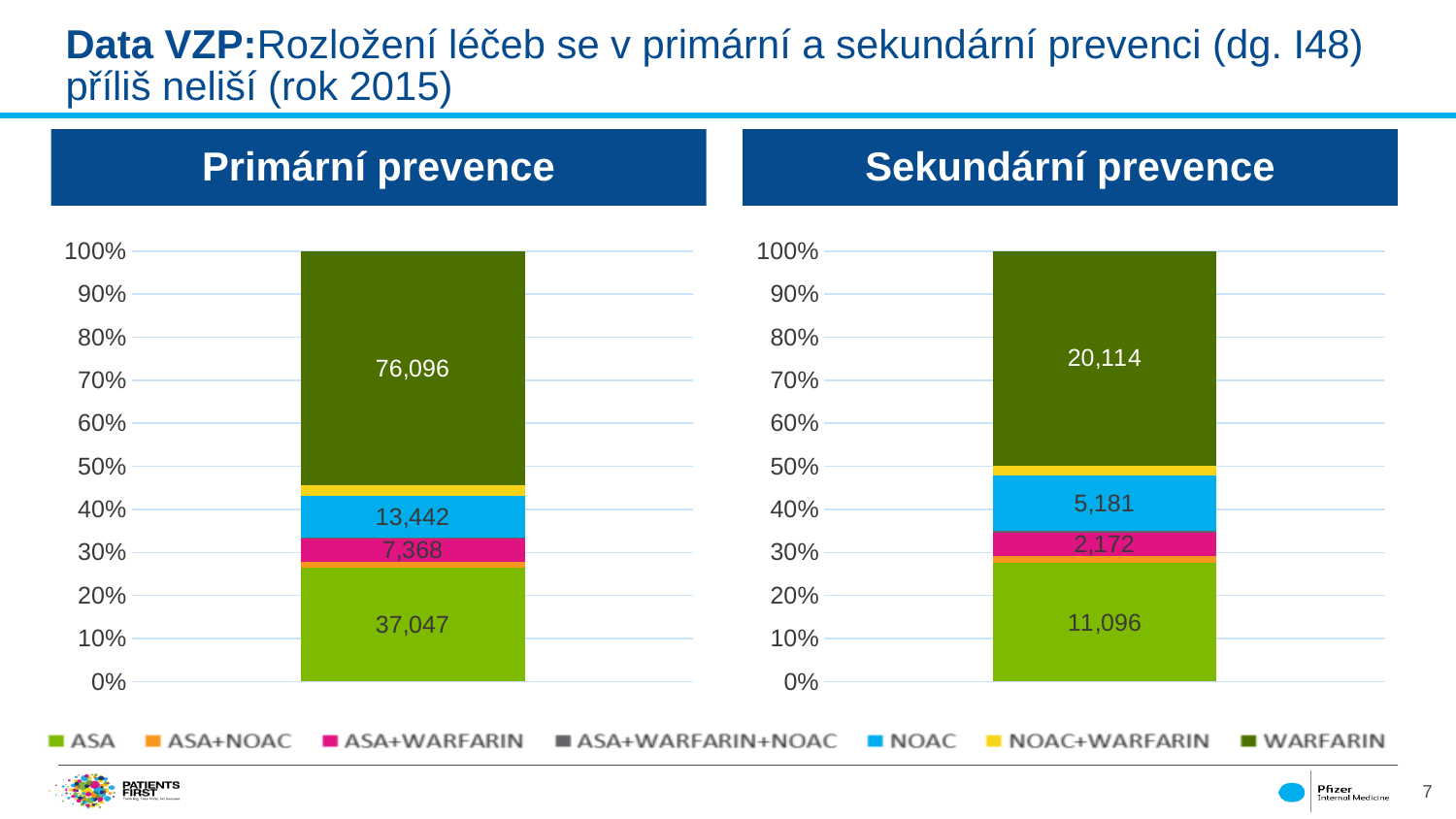
In the Primární prevence chart, is the share of the WARFARIN segment greater or less than 50%? greater In the Primární prevence chart, which labelled segment has the largest value? WARFARIN In the Sekundární prevence chart, what is the value labelled on the NOAC segment? 5,181 In the Sekundární prevence chart, what is the value labelled on the ASA+WARFARIN segment? 2,172 In the Primární prevence chart, what is the difference between the WARFARIN value and the ASA value? 39,049 Which is larger: the ASA value in the Primární prevence chart or the ASA value in the Sekundární prevence chart? Primární prevence In the Primární prevence chart, what is the value labelled on the WARFARIN segment? 76,096 In the Sekundární prevence chart, what is the difference between the NOAC value and the ASA+WARFARIN value? 3,009 In the Primární prevence chart, what is the value labelled on the ASA segment? 37,047 How many series does the shared legend list? 7 What kind of chart is the Sekundární prevence chart? Stacked bar chart In the Sekundární prevence chart, which labelled segment has the smallest value? ASA+WARFARIN